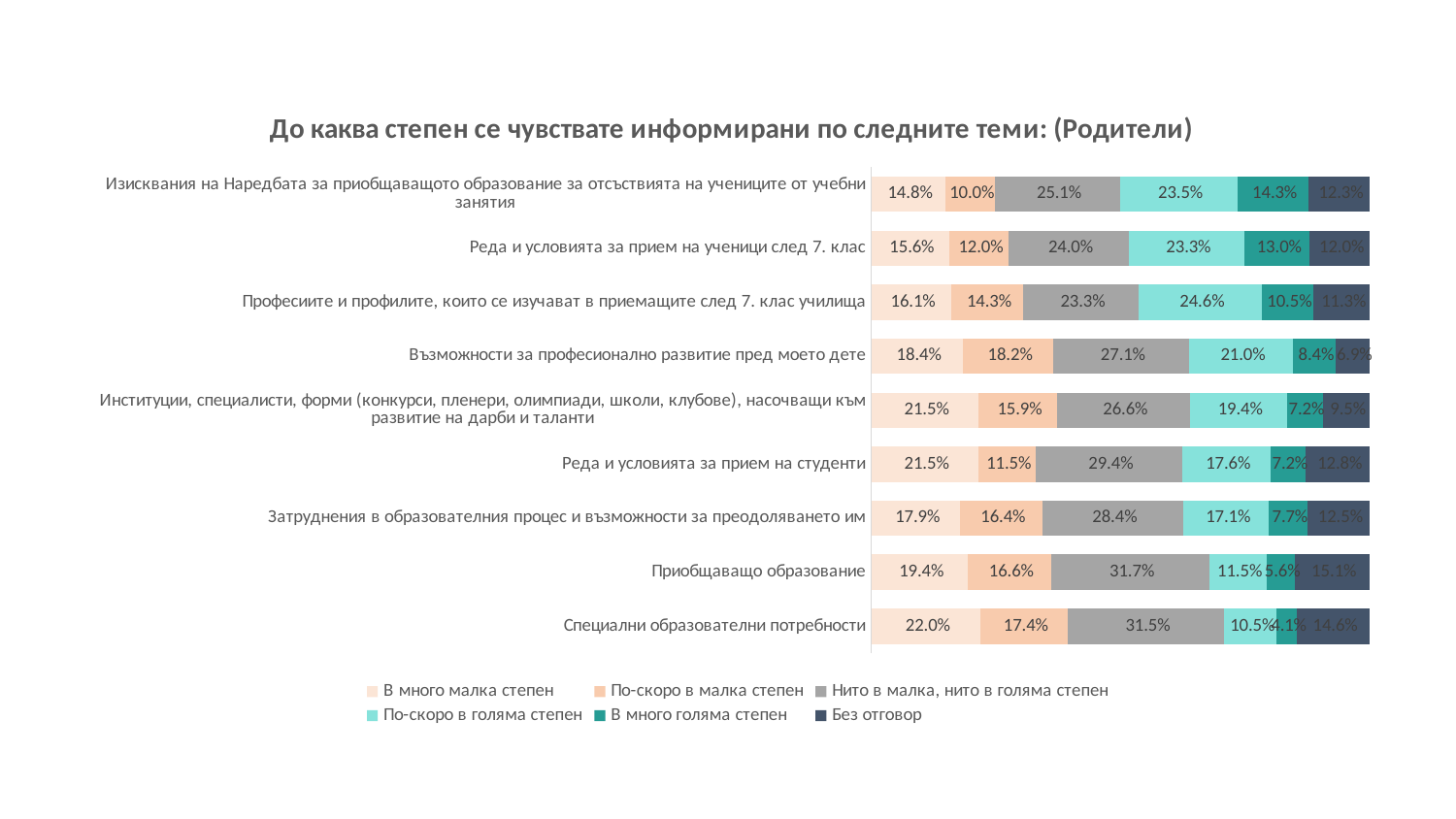
Which category has the lowest value for "В много голяма степен"? Специални образователни потребности What is the "Нито в малка, нито в голяма степен" value for "Реда и условията за прием на студенти"? 29.4% What share of respondents chose "Без отговор" for "Приобщаващо образование"? 15.1% Which is larger: the "По-скоро в малка степен" value for "Възможности за професионално развитие пред моето дете" or for "Реда и условията за прием на студенти"? Възможности за професионално развитие пред моето дете What percentage of parents answered "В много малка степен" for "Специални образователни потребности"? 22.0% What is the difference between the "В много малка степен" values for "Специални образователни потребности" and "Изисквания на Наредбата за приобщаващото образование за отсъствията на учениците от учебни занятия"? 7.2 percentage points What kind of chart is shown on the slide? Stacked bar chart What is the value for "По-скоро в голяма степен" in the "Професиите и профилите, които се изучават в приемащите след 7. клас училища" bar? 24.6% How many categories (topics) are shown in the chart? 9 Which category has the highest value for "В много голяма степен"? Изисквания на Наредбата за приобщаващото образование за отсъствията на учениците от учебни занятия What is the title of the chart? До каква степен се чувствате информирани по следните теми: (Родители) How many series does the legend list? 6